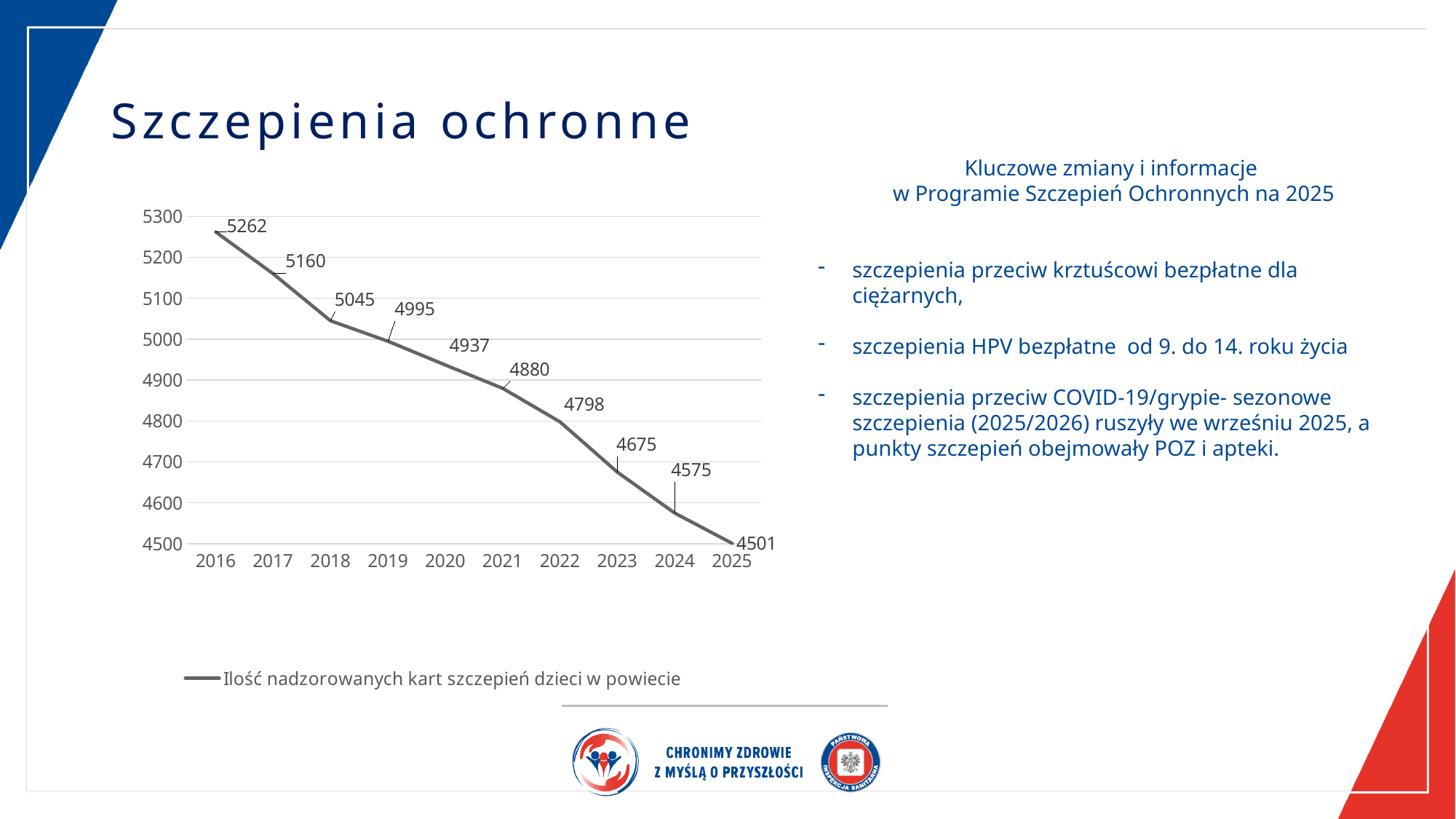
Which is larger, the value for 2018 or the value for 2022? 2018 What is the value for 2016? 5262 What is the difference between the values for 2023 and 2024? 100 Which year has the lowest value? 2025 How many years are plotted on the x axis? 10 Is the value for 2021 greater or less than 4800? greater Do the values rise or fall from 2016 to 2025? fall What kind of chart is shown? line chart What is the difference between the values for 2016 and 2025? 761 What is the value for 2020? 4937 Which year has the highest value? 2016 What is the value for 2025? 4501